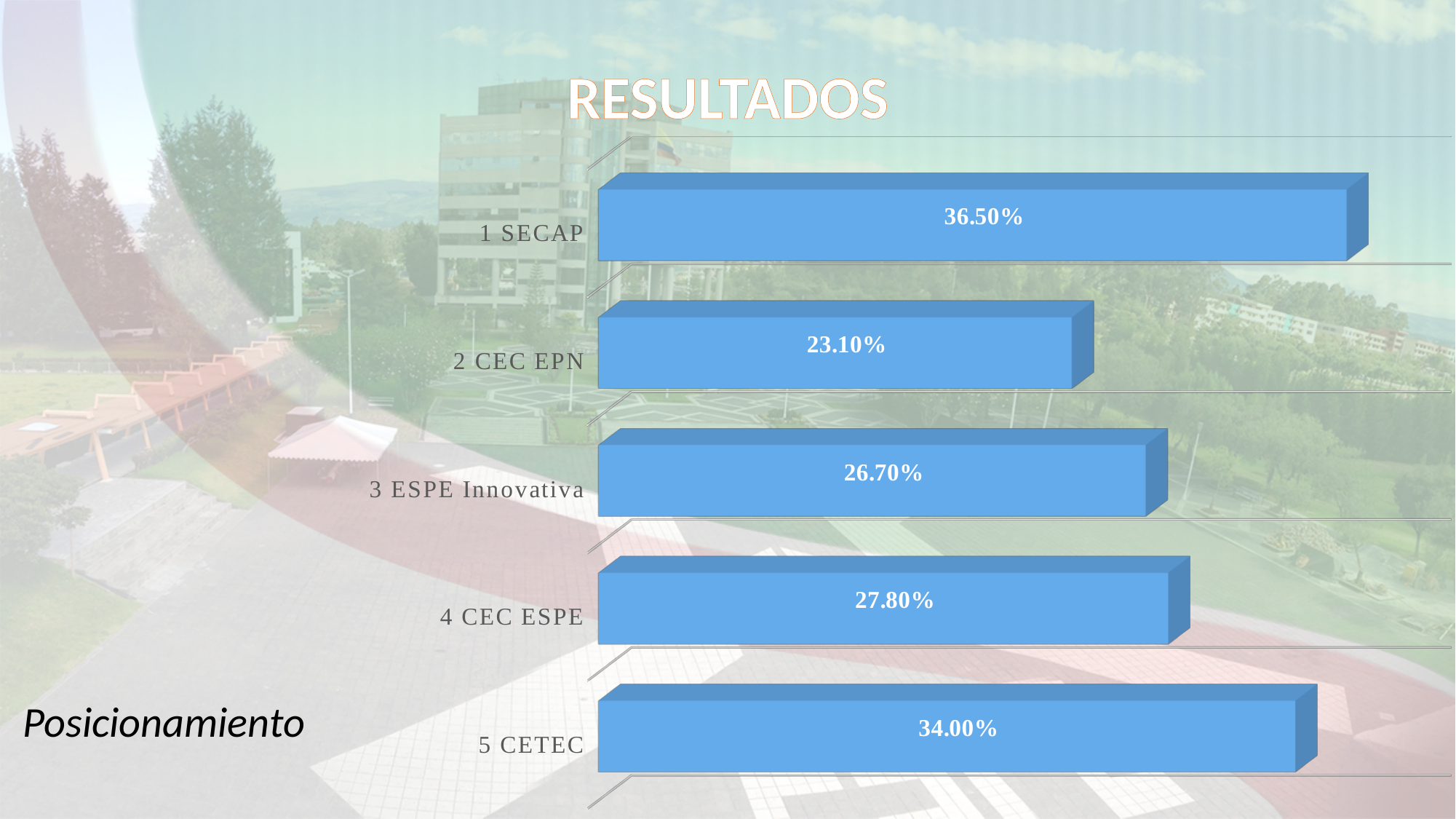
What is the difference between the values for 4 CEC ESPE and 2 CEC EPN? 4.70% What is the value for 5 CETEC? 34.00% What is the difference between the values for 1 SECAP and 5 CETEC? 2.50% What is the value for 3 ESPE Innovativa? 26.70% What is the title shown above the chart? RESULTADOS Which category has the lowest value? 2 CEC EPN Which is larger, the value for 4 CEC ESPE or the value for 3 ESPE Innovativa? 4 CEC ESPE What is the value for 1 SECAP? 36.50% Which category has the highest value? 1 SECAP What kind of chart is shown on the slide? Bar chart How many categories are shown in the chart? 5 What is the value for 2 CEC EPN? 23.10%